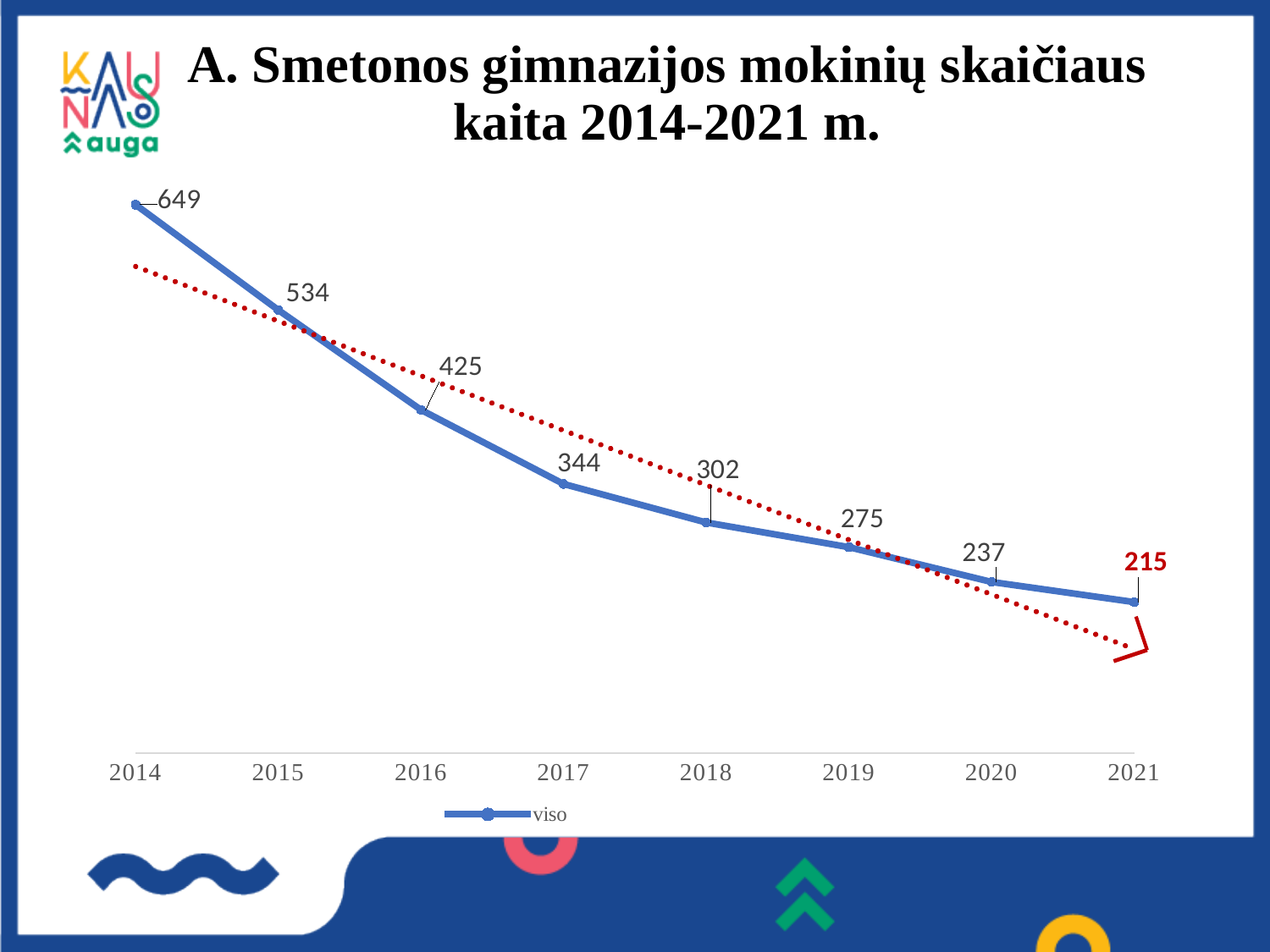
Which is larger, the value for 2018 or the value for 2019? 2018 What is the difference between the values for 2015 and 2016? 109 How many years are plotted on the x axis? 8 Which year has the highest value? 2014 What kind of chart is this? line chart Which year has the lowest value? 2021 What is the value for 2017? 344 What is the value for 2021? 215 What is the difference between the values for 2014 and 2021? 434 Do the values rise or fall from 2014 to 2021? fall What is the value for 2014? 649 What series name does the legend show? viso